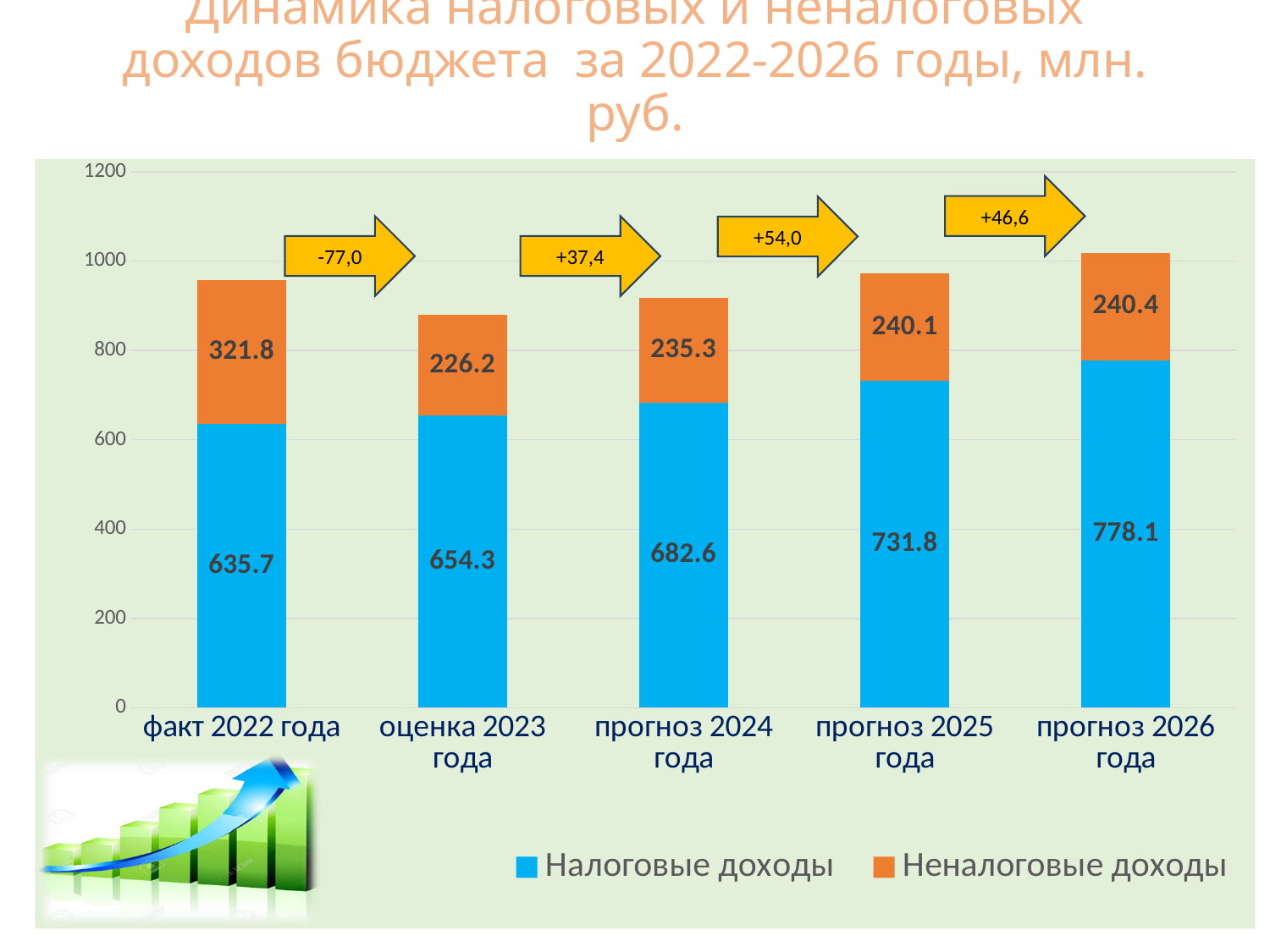
Which is larger: Неналоговые доходы for факт 2022 года or for прогноз 2024 года? факт 2022 года What is the value of Неналоговые доходы for прогноз 2025 года? 240.1 Which category has the highest value of Налоговые доходы? прогноз 2026 года How many series does the legend list? 2 Which category has the lowest value of Неналоговые доходы? оценка 2023 года What is the value of Налоговые доходы for факт 2022 года? 635.7 How many categories are shown on the x axis? 5 Do the values of Налоговые доходы rise or fall from факт 2022 года to прогноз 2026 года? rise What is the total of the stacked bar for оценка 2023 года? 880.5 What is the value of Налоговые доходы for прогноз 2024 года? 682.6 What type of chart is shown on the slide? stacked bar chart What is the difference between Налоговые доходы for прогноз 2026 года and прогноз 2025 года? 46.3